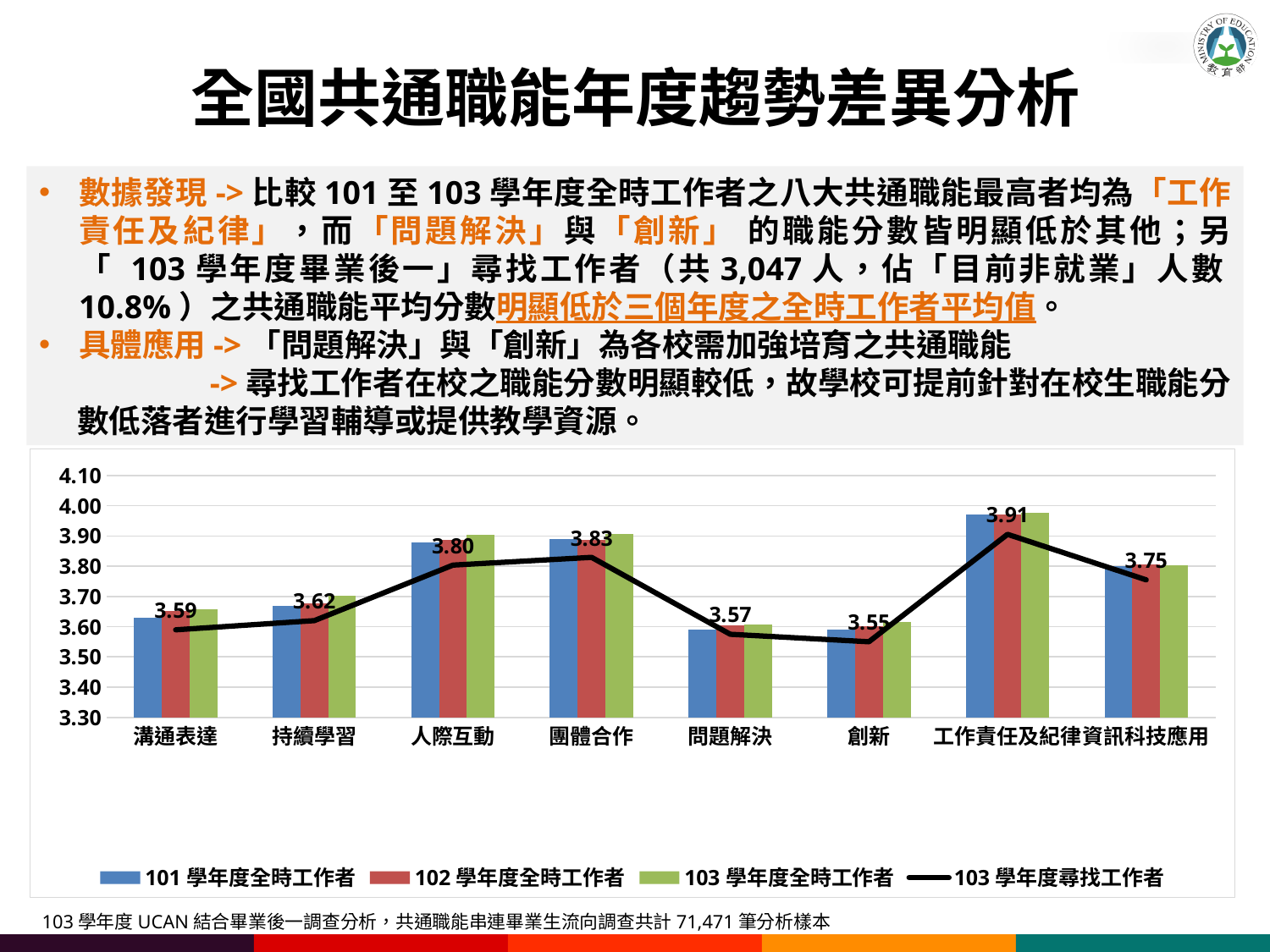
For 103 學年度尋找工作者, which is larger: 人際互動 or 團體合作? 團體合作 What is the value of 103 學年度尋找工作者 for 工作責任及紀律? 3.91 Which series is drawn as a black line? 103 學年度尋找工作者 Is the value of 101 學年度全時工作者 for 創新 greater or less than 3.70? less What is the difference between the 103 學年度尋找工作者 values for 工作責任及紀律 and 創新? 0.36 Is the value of 101 學年度全時工作者 for 工作責任及紀律 greater or less than 3.90? greater What is the value of 103 學年度尋找工作者 for 持續學習? 3.62 How many categories are shown on the x axis? 8 Which category has the lowest value for 103 學年度尋找工作者? 創新 What is the value of 103 學年度尋找工作者 for 創新? 3.55 How many series does the legend list? 4 Which category has the highest value for 103 學年度尋找工作者? 工作責任及紀律